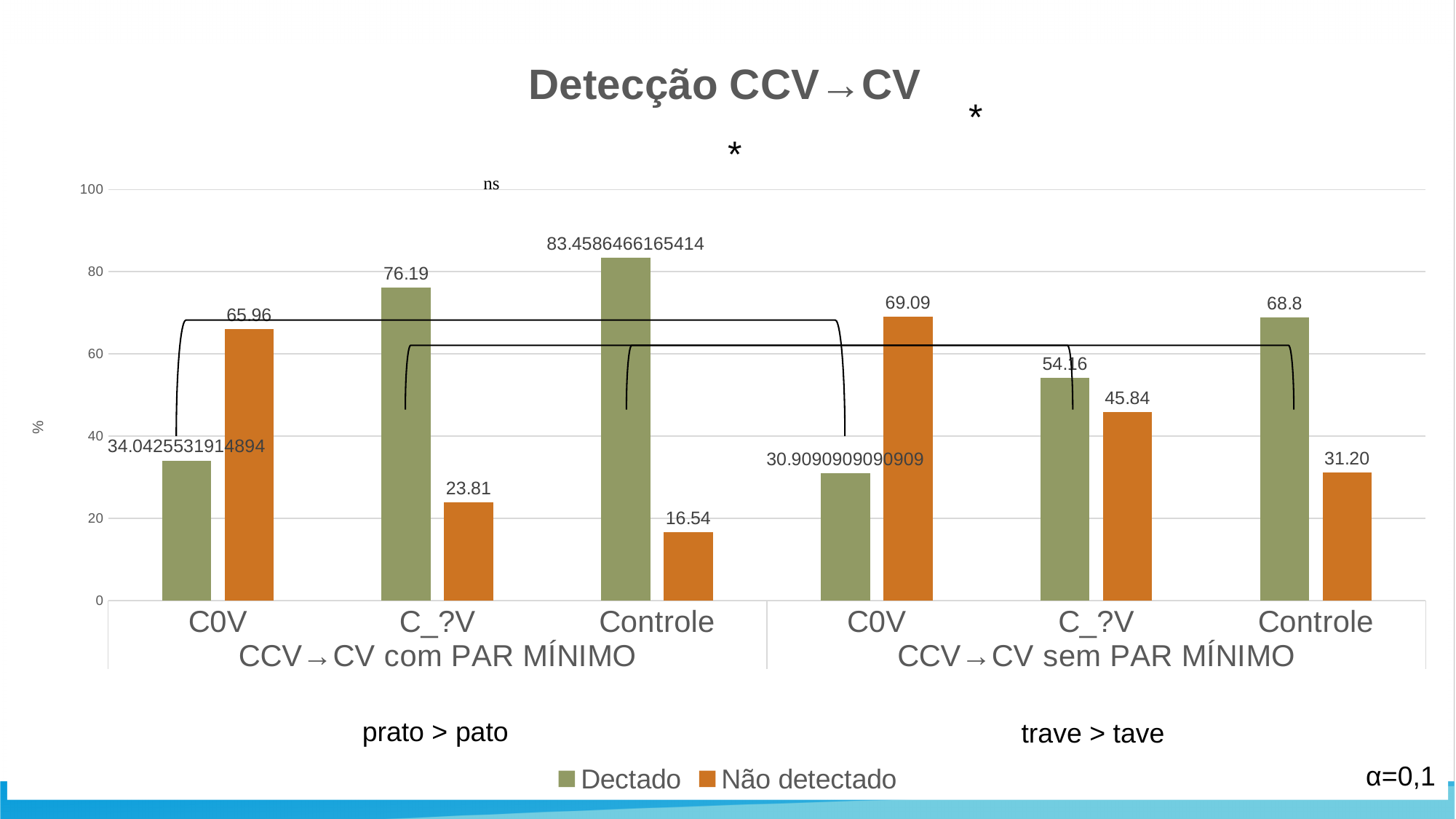
Which is larger for C0V in the CCV→CV sem PAR MÍNIMO group: Dectado or Não detectado? Não detectado What is the Não detectado value for C0V in the CCV→CV com PAR MÍNIMO group? 65.96 What is the title of the chart? Detecção CCV→CV Which category has the lowest Não detectado value across the whole chart? Controle (CCV→CV com PAR MÍNIMO) What is the Dectado value for C_?V in the CCV→CV com PAR MÍNIMO group? 76.19 What kind of chart is shown on the slide? bar chart How many series does the legend list? 2 Which category has the highest Dectado value across the whole chart? Controle (CCV→CV com PAR MÍNIMO) What is the difference between the Dectado and Não detectado values for C_?V in the CCV→CV sem PAR MÍNIMO group? 8.32 What is the Não detectado value for Controle in the CCV→CV sem PAR MÍNIMO group? 31.20 Is the Dectado value for C0V in the CCV→CV sem PAR MÍNIMO group greater or less than 40? less How many category groups (x-axis labels) are shown in the chart? 6